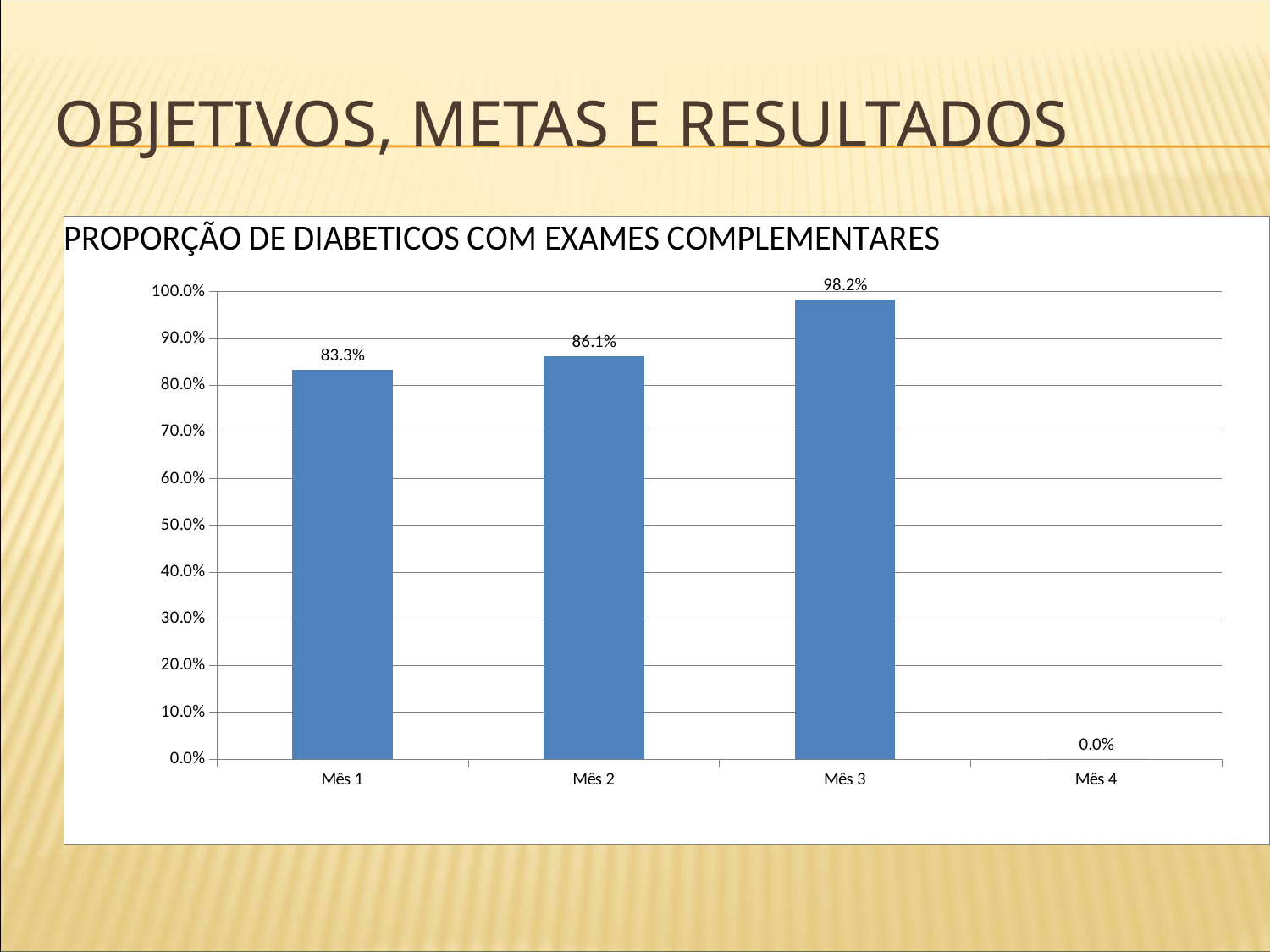
What is the value for Mês 3? 98.2% Which is larger, the value for Mês 2 or the value for Mês 3? Mês 3 How many months are shown on the x axis? 4 Which month has the highest value? Mês 3 What is the value for Mês 1? 83.3% What is the difference between the values for Mês 2 and Mês 1? 2.8% What is the title of the chart? PROPORÇÃO DE DIABETICOS COM EXAMES COMPLEMENTARES What is the value for Mês 2? 86.1% Which month has the lowest value? Mês 4 What is the difference between the values for Mês 3 and Mês 1? 14.9% What kind of chart is shown on the slide? Bar chart What is the value for Mês 4? 0.0%